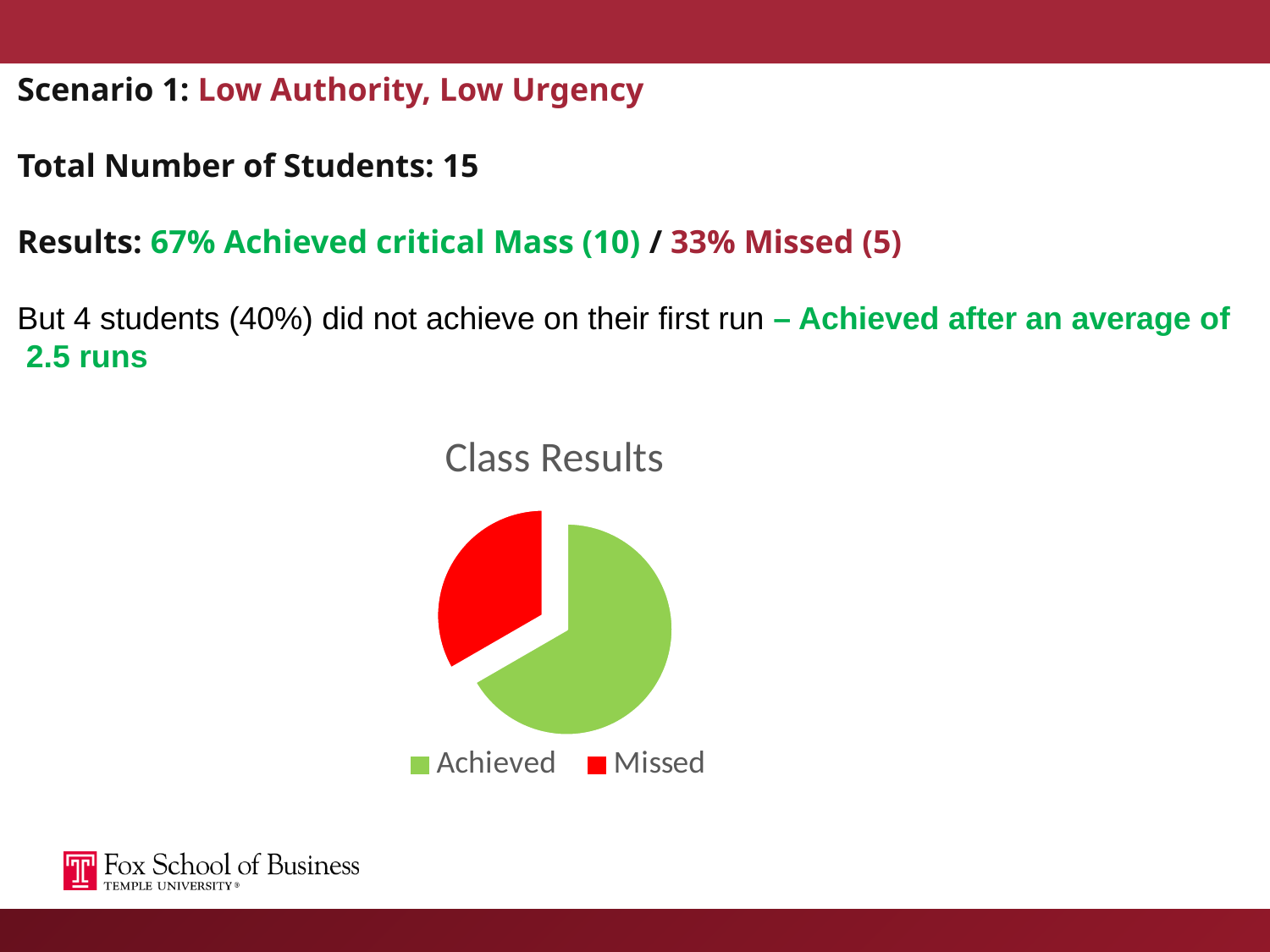
Which slice of the "Class Results" pie chart is the largest? Achieved What is the title of the pie chart on the slide? Class Results According to the slide, what share of the class does the Achieved slice represent? 67% How many slices does the "Class Results" pie chart have? 2 Which slice of the "Class Results" pie chart is the smallest? Missed According to the slide, how many more students Achieved than Missed? 5 How many entries does the legend of the "Class Results" chart list? 2 According to the slide, how many students are in the Achieved slice of the "Class Results" chart? 10 What colour is the Missed slice in the "Class Results" pie chart? red According to the slide, what share of the class does the Missed slice represent? 33% What kind of chart is the "Class Results" chart? pie chart In the "Class Results" pie chart, which is larger: Achieved or Missed? Achieved